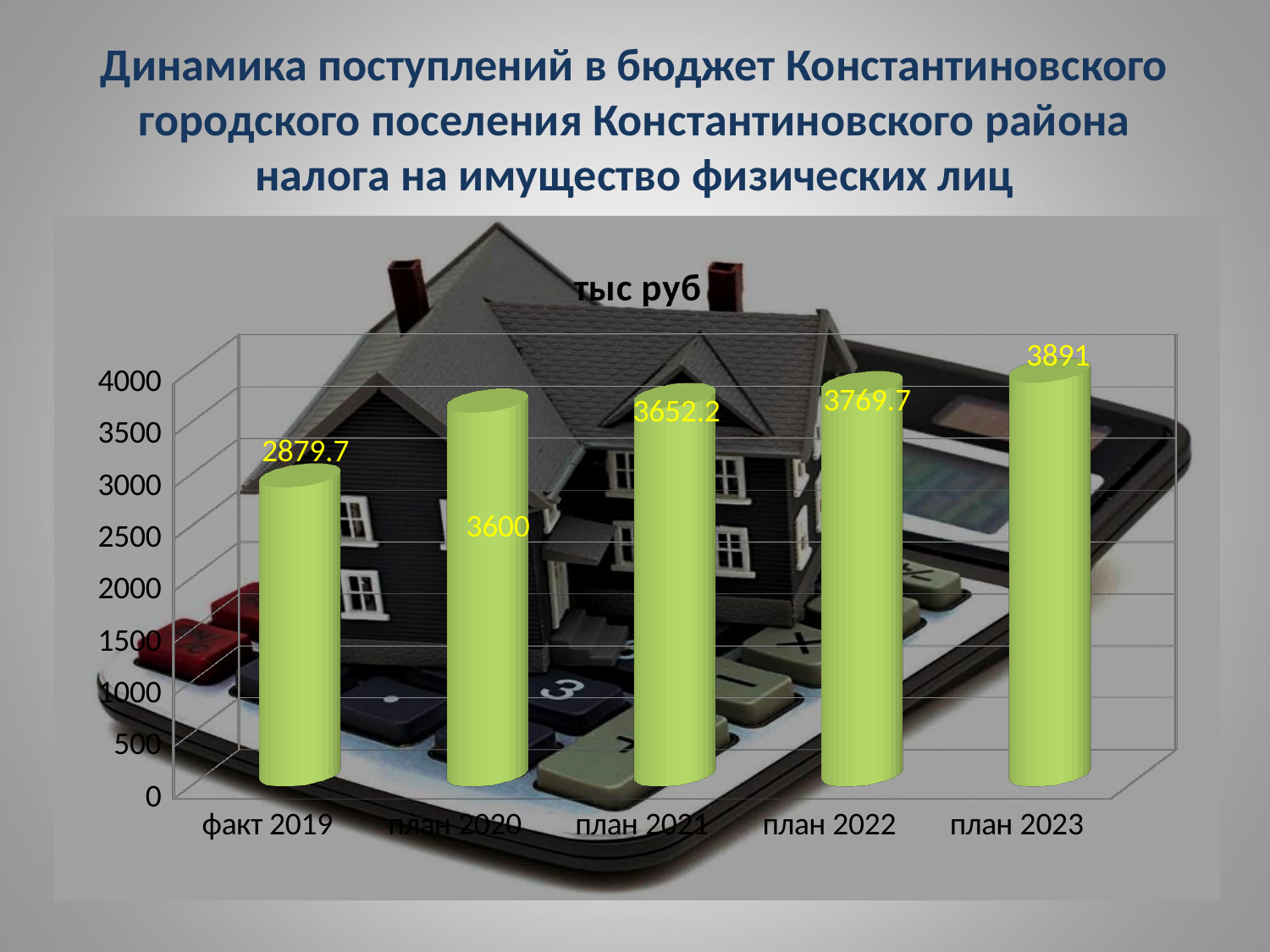
What is the value for план 2020? 3600 Which category has the lowest value? факт 2019 What is the difference between the values for план 2023 and факт 2019? 1011.3 How many categories are shown on the x axis? 5 What is the value for факт 2019? 2879.7 Which category has the highest value? план 2023 What is the value for план 2021? 3652.2 Which is larger, the value for план 2021 or the value for план 2020? план 2021 What is the value for план 2022? 3769.7 What is the value for план 2023? 3891 What kind of chart is shown on the slide? bar chart Do the values rise or fall from факт 2019 to план 2023? rise